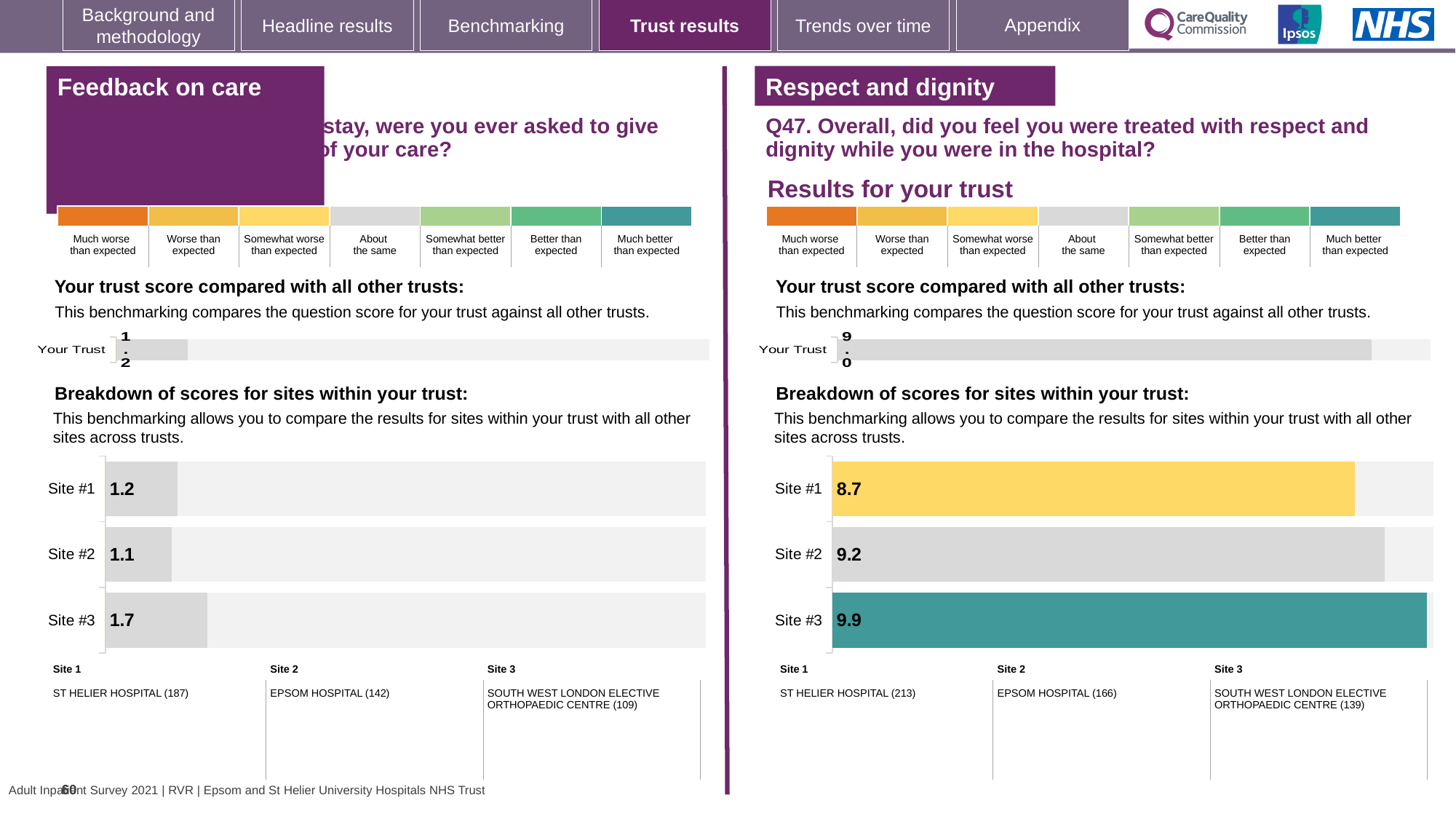
What type of chart is used for the 'Respect and dignity' site breakdown? Bar chart In the 'Respect and dignity' section, what is the 'Your Trust' score shown in the trust comparison chart? 9.0 In the 'Respect and dignity' site breakdown chart, what is the score for Site #2? 9.2 In the 'Feedback on care' site breakdown chart, which site has the highest score? Site #3 In the 'Respect and dignity' site breakdown chart, which site has the lowest score? Site #1 In the 'Respect and dignity' site breakdown chart, what is the score for Site #3? 9.9 In the 'Respect and dignity' site breakdown chart, which has the larger score, Site #1 or Site #2? Site #2 In the 'Feedback on care' site breakdown chart, what is the score for Site #3? 1.7 In the 'Respect and dignity' site breakdown chart, what is the difference between the scores for Site #3 and Site #1? 1.2 How many sites are shown in the 'Feedback on care' site breakdown chart? 3 In the 'Feedback on care' site breakdown chart, what is the score for Site #1? 1.2 In the 'Feedback on care' site breakdown chart, what is the difference between the scores for Site #3 and Site #2? 0.6